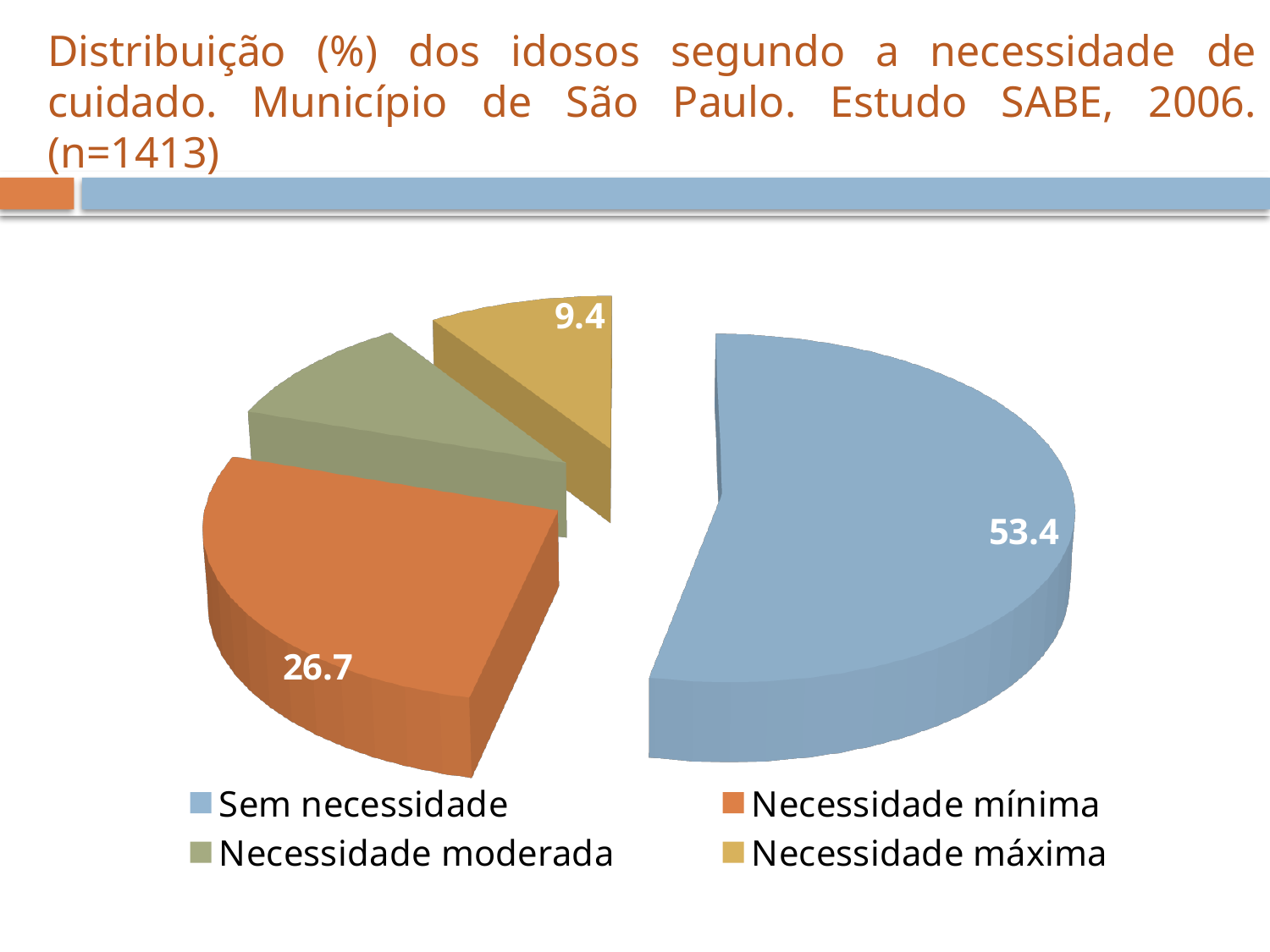
What is the difference between the values for 'Sem necessidade' and 'Necessidade mínima'? 26.7 What value is shown for 'Necessidade mínima'? 26.7 What value is shown for 'Necessidade máxima'? 9.4 Which is larger, 'Necessidade mínima' or 'Necessidade máxima'? Necessidade mínima What kind of chart is shown on the slide? Pie chart Which is larger, 'Sem necessidade' or 'Necessidade mínima'? Sem necessidade How many categories does the pie chart show? 4 What percentage of the elderly are in the 'Sem necessidade' category? 53.4 Which category has the largest slice of the pie? Sem necessidade What is the difference between the values for 'Necessidade mínima' and 'Necessidade máxima'? 17.3 What is the difference between the values for 'Sem necessidade' and 'Necessidade máxima'? 44.0 What colour is the 'Sem necessidade' slice? Blue